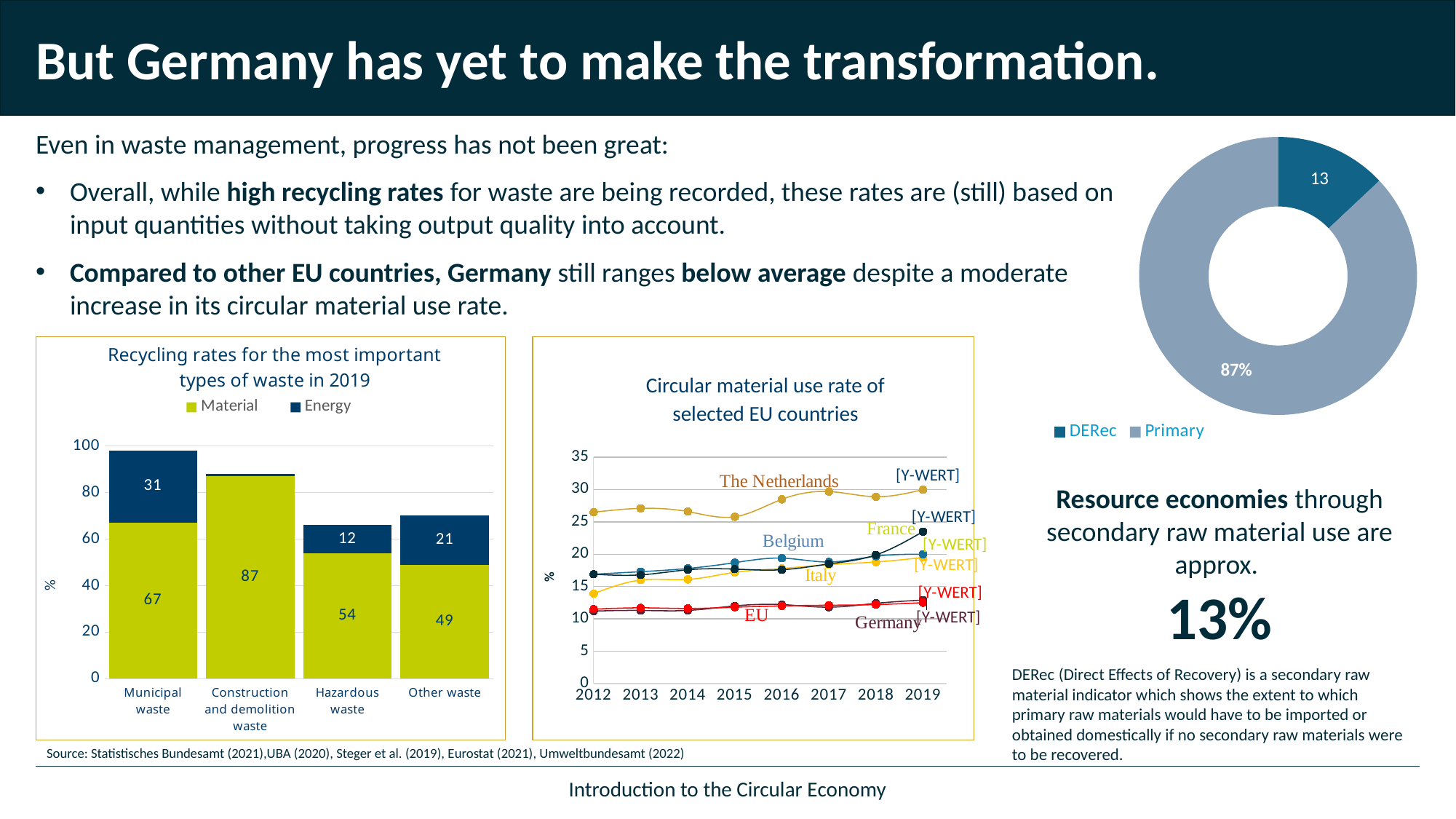
What kind of chart is 'Recycling rates for the most important types of waste in 2019'? Stacked bar chart In the chart 'Recycling rates for the most important types of waste in 2019', which waste type has the highest Material value? Construction and demolition waste In the chart 'Recycling rates for the most important types of waste in 2019', what is the Material value for Municipal waste? 67 In the chart 'Circular material use rate of selected EU countries', does the line for France rise or fall from 2012 to 2019? rise In the chart 'Circular material use rate of selected EU countries', is the value for The Netherlands in 2019 greater or less than 25? greater In the chart 'Recycling rates for the most important types of waste in 2019', what is the difference between the Material values for Municipal waste and Hazardous waste? 13 In the chart 'Recycling rates for the most important types of waste in 2019', what is the Energy value for Other waste? 21 In the donut chart on the right, what share of the total is Primary? 87% In the chart 'Recycling rates for the most important types of waste in 2019', what is the total of the stacked bar for Hazardous waste? 66 In the chart 'Recycling rates for the most important types of waste in 2019', which waste type has the lowest Material value? Other waste In the chart 'Circular material use rate of selected EU countries', how many years are shown on the x axis? 8 In the chart 'Recycling rates for the most important types of waste in 2019', how many series does the legend list? 2